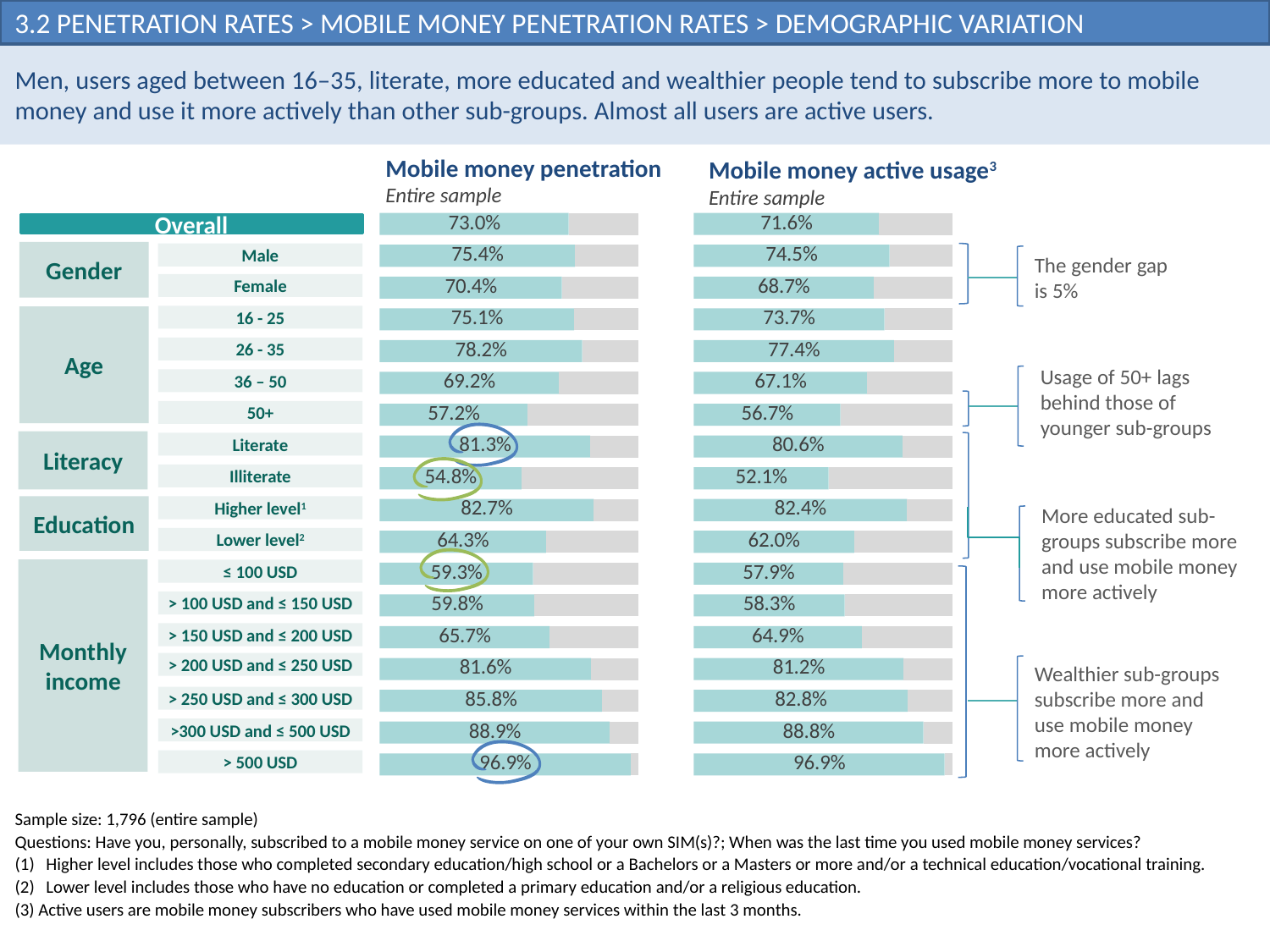
In the Mobile money active usage chart, do the values rise or fall as monthly income increases from ≤ 100 USD to > 500 USD? rise What kind of chart is used to show Mobile money penetration? bar chart In the Mobile money penetration chart, which is larger, the value for 16 - 25 or the value for 36 – 50? 16 - 25 In the Mobile money active usage chart, what is the value for Lower level education? 62.0% In the Mobile money penetration chart, what is the value for the Overall row? 73.0% In the Mobile money penetration chart, what is the value for the 26 - 35 age group? 78.2% In the Mobile money penetration chart, which sub-group has the lowest value? Illiterate In the Mobile money penetration chart, what is the difference between the Male and Female values? 5.0 percentage points In the Mobile money active usage chart, what is the difference between the Higher level and Lower level education values? 20.4 percentage points In the Mobile money active usage chart, what is the value for Female? 68.7% In the Mobile money penetration chart, which sub-group has the highest value? > 500 USD In the Mobile money active usage chart, which sub-group has the lowest value? Illiterate